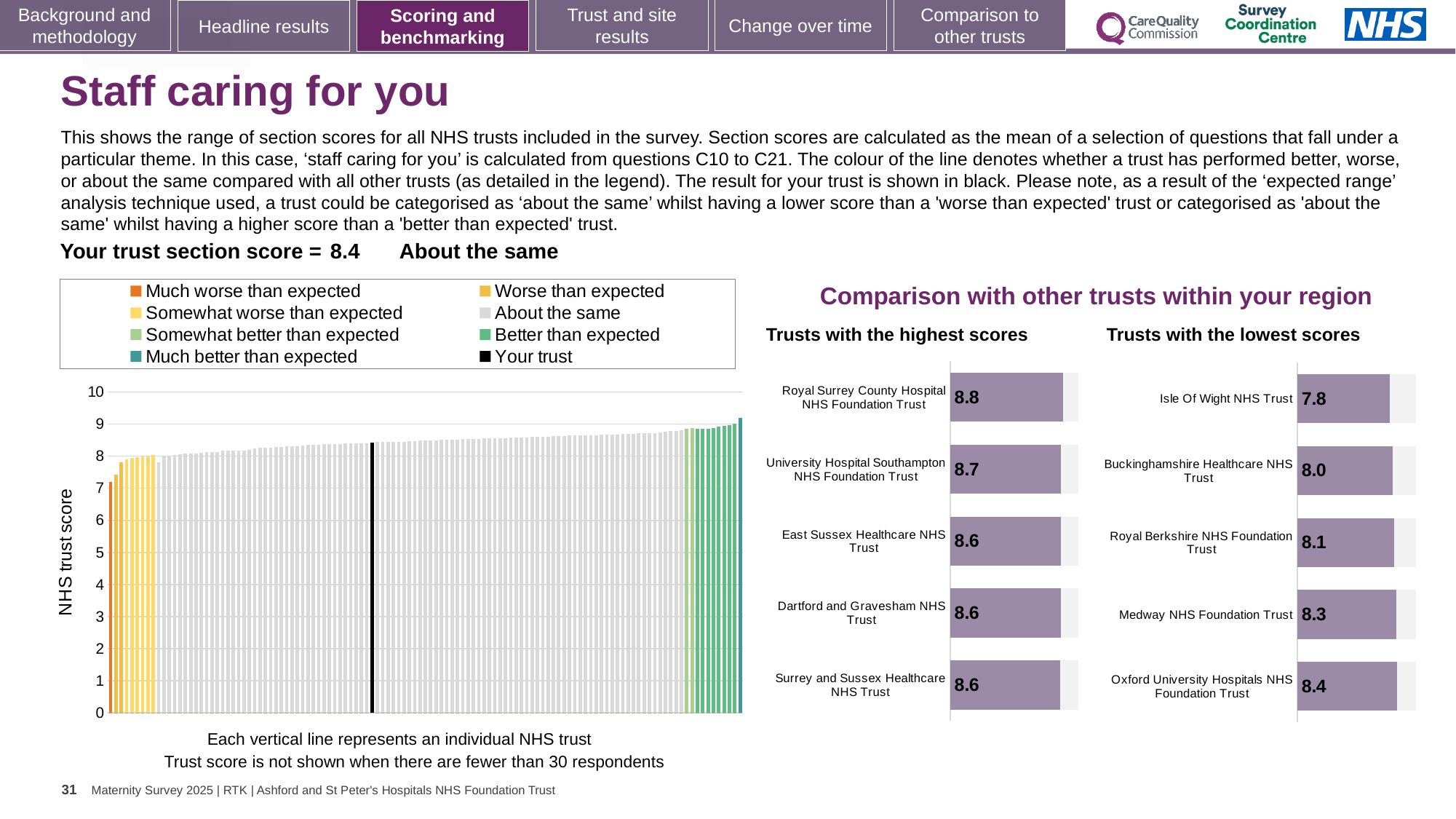
How many entries does the legend of the main 'NHS trust score' chart list? 8 In the 'Trusts with the lowest scores' chart, which has the higher score: Medway NHS Foundation Trust or Buckinghamshire Healthcare NHS Trust? Medway NHS Foundation Trust In the 'Trusts with the highest scores' chart, what is the score for University Hospital Southampton NHS Foundation Trust? 8.7 In the 'Trusts with the lowest scores' chart, what is the score for Isle Of Wight NHS Trust? 7.8 What kind of chart is the main chart on the left with the 'NHS trust score' axis? bar chart How many trusts are shown in the 'Trusts with the highest scores' chart? 5 In the 'Trusts with the highest scores' chart, which trust has the highest score? Royal Surrey County Hospital NHS Foundation Trust In the main chart on the left, is the value of the black 'Your trust' bar greater or less than 8? greater In the 'Trusts with the highest scores' chart, what is the score for Royal Surrey County Hospital NHS Foundation Trust? 8.8 In the 'Trusts with the lowest scores' chart, what is the difference between the scores of Oxford University Hospitals NHS Foundation Trust and Isle Of Wight NHS Trust? 0.6 In the main 'NHS trust score' chart, do the bar heights rise or fall from left to right? rise In the 'Trusts with the lowest scores' chart, which trust has the lowest score? Isle Of Wight NHS Trust